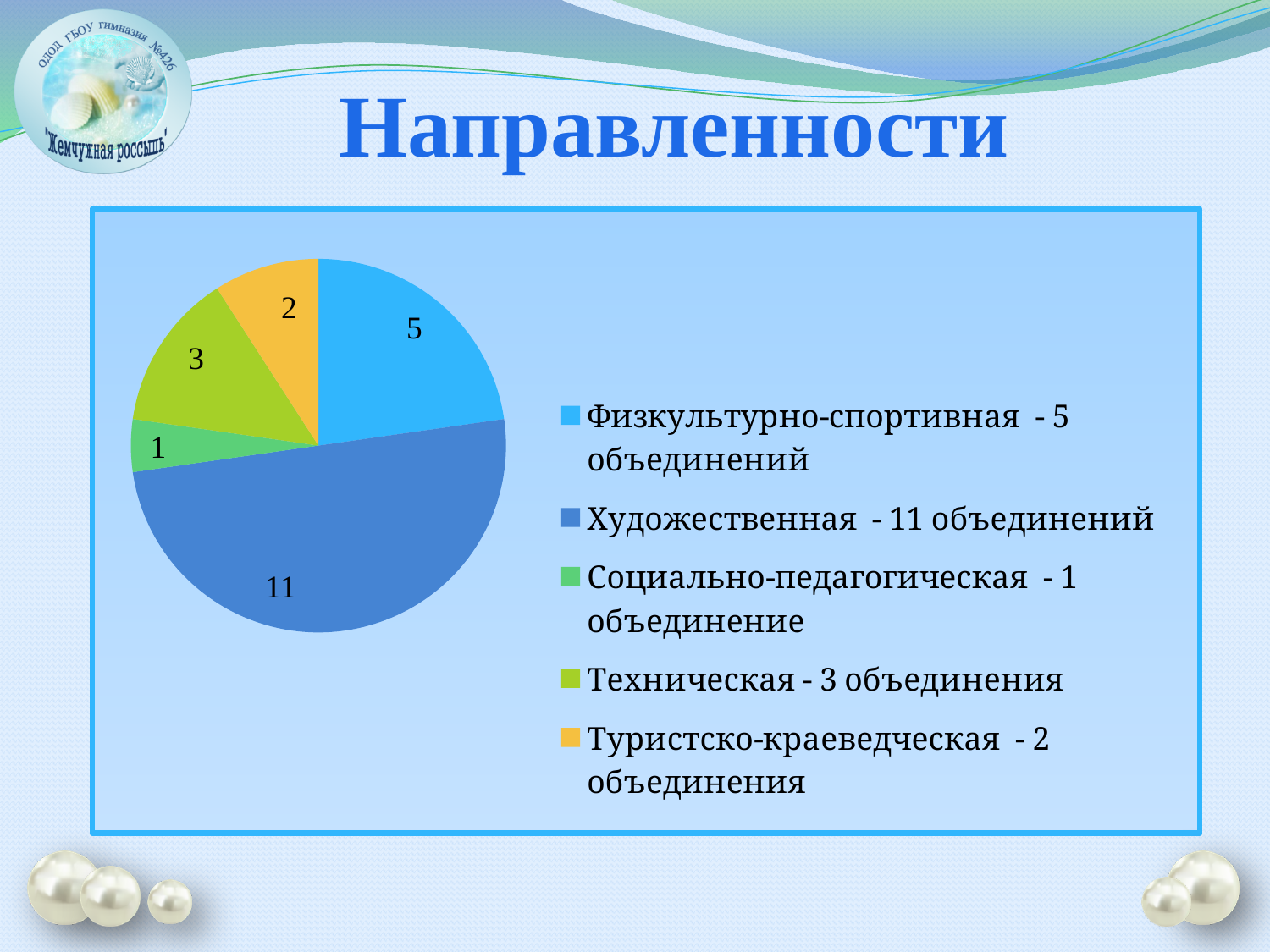
What value is shown for the Художественная slice? 11 What value is shown for the Туристско-краеведческая slice? 2 Which is larger, the value for Техническая or the value for Туристско-краеведческая? Техническая Which category has the largest slice of the pie? Художественная How many entries does the legend list? 5 How many slices does the pie chart have? 5 Which category has the smallest slice of the pie? Социально-педагогическая What is the difference between the values for Художественная and Физкультурно-спортивная? 6 What is the title of the slide containing the chart? Направленности What kind of chart is shown on the slide? pie chart What share of the pie does the Художественная slice represent? 50% What value is shown for the Физкультурно-спортивная slice? 5